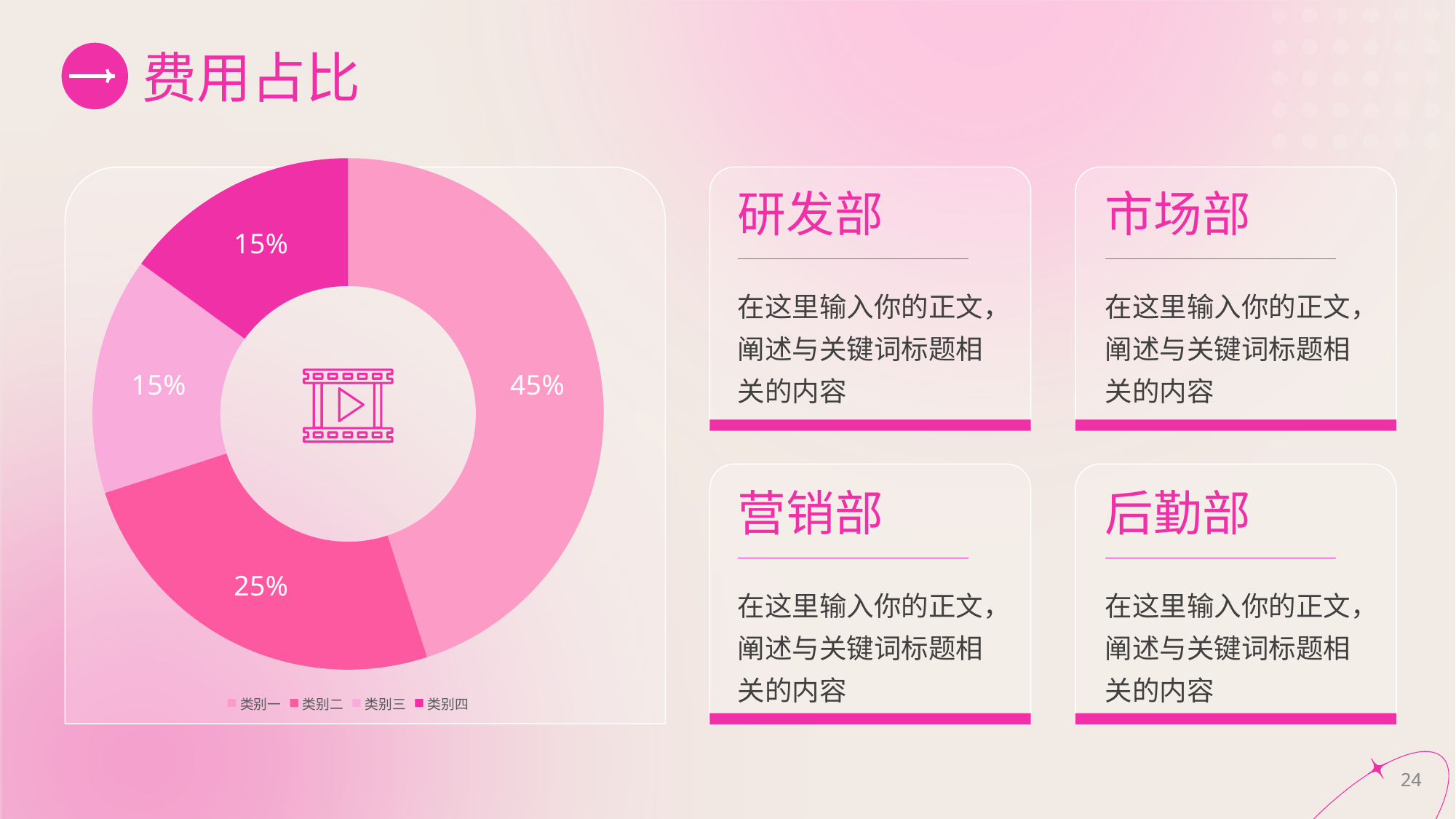
What is the title of the slide containing the chart? 费用占比 What kind of chart is shown on the slide? Doughnut (pie) chart What is the value shown for 类别三? 15% Which category has the largest share of the doughnut chart? 类别一 What is the combined share of 类别三 and 类别四? 30% How many entries does the legend list? 4 How many categories are shown in the doughnut chart? 4 What is the value shown for 类别二? 25% Which is larger, the share of 类别二 or the share of 类别三? 类别二 What is the value shown for 类别四? 15% What is the value shown for 类别一? 45% What is the difference between the shares of 类别一 and 类别二? 20 percentage points